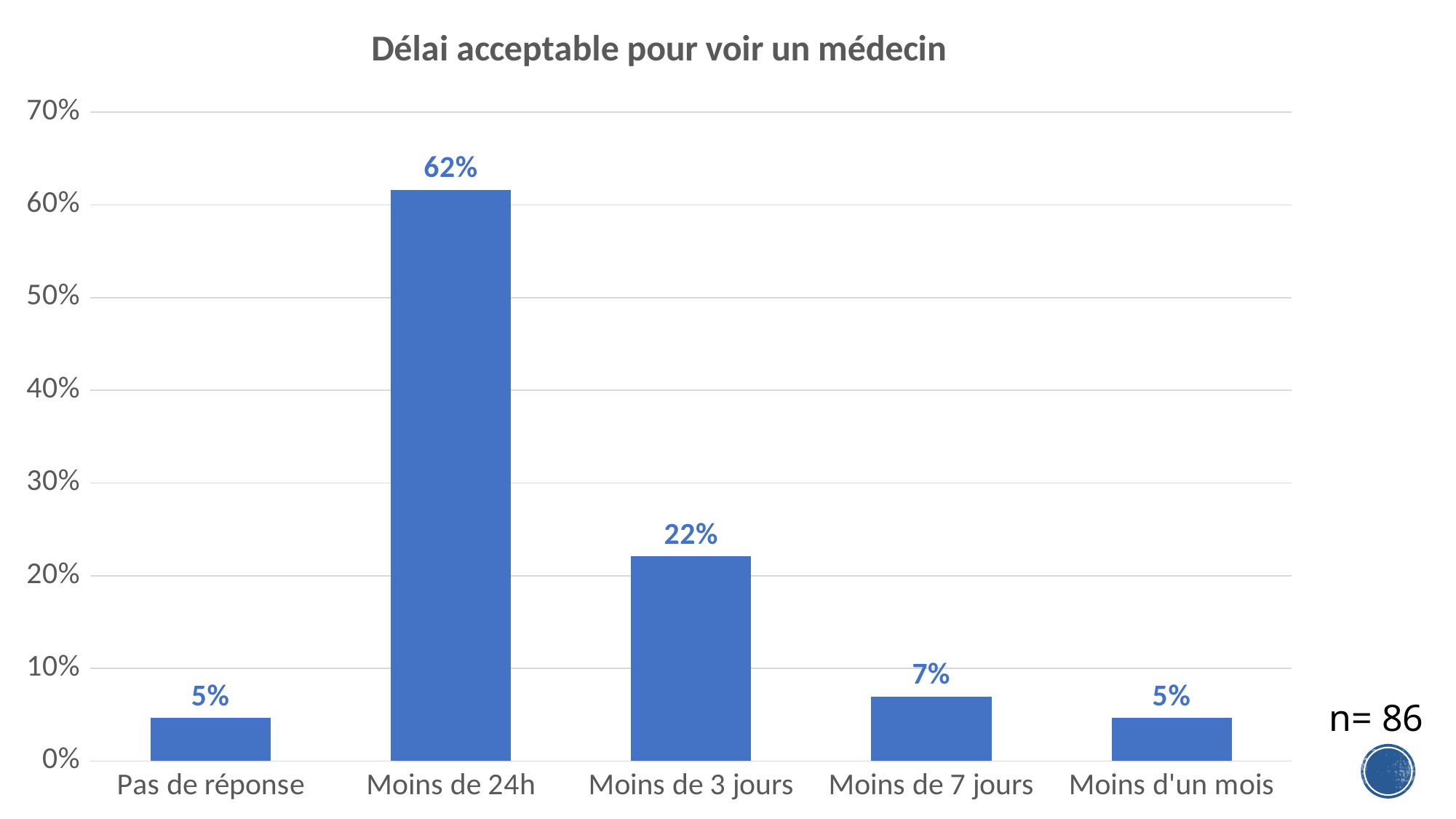
What kind of chart is shown on the slide? bar chart How many categories are shown on the x axis? 5 Which is larger, the value for "Moins de 3 jours" or the value for "Moins de 7 jours"? Moins de 3 jours What is the value for "Moins de 3 jours"? 22% What is the value for "Moins de 24h"? 62% What is the difference between the values for "Moins de 24h" and "Moins de 3 jours"? 40% Which category has the highest value? Moins de 24h What is the value for "Pas de réponse"? 5% What is the value for "Moins de 7 jours"? 7% Is the value for "Moins de 24h" greater or less than 60%? greater What is the difference between the values for "Moins de 3 jours" and "Moins de 7 jours"? 15% What is the title of the chart? Délai acceptable pour voir un médecin